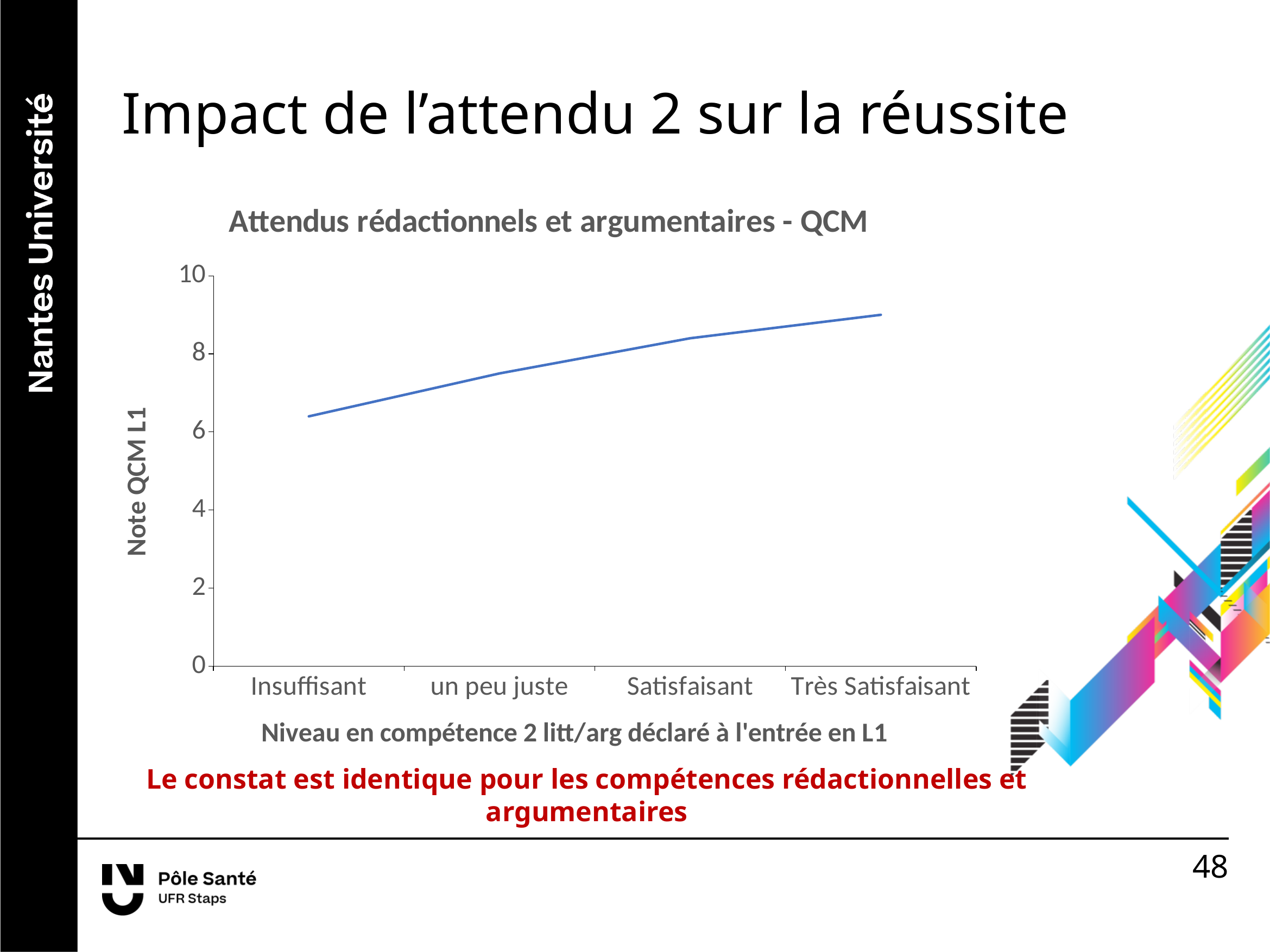
What is the title of the chart? Attendus rédactionnels et argumentaires - QCM Which category has the lowest Note QCM L1? Insuffisant Which has a higher Note QCM L1, Insuffisant or Satisfaisant? Satisfaisant Do the values rise or fall along the x axis from Insuffisant to Très Satisfaisant? rise Is the value for Très Satisfaisant greater or less than 8? greater What is the label of the vertical axis of the chart? Note QCM L1 What kind of chart is shown on the slide? line chart Which category has the highest Note QCM L1? Très Satisfaisant Is the value for un peu juste greater or less than 8? less Is the value for Satisfaisant greater or less than 6? greater How many categories are shown on the x axis of the chart? 4